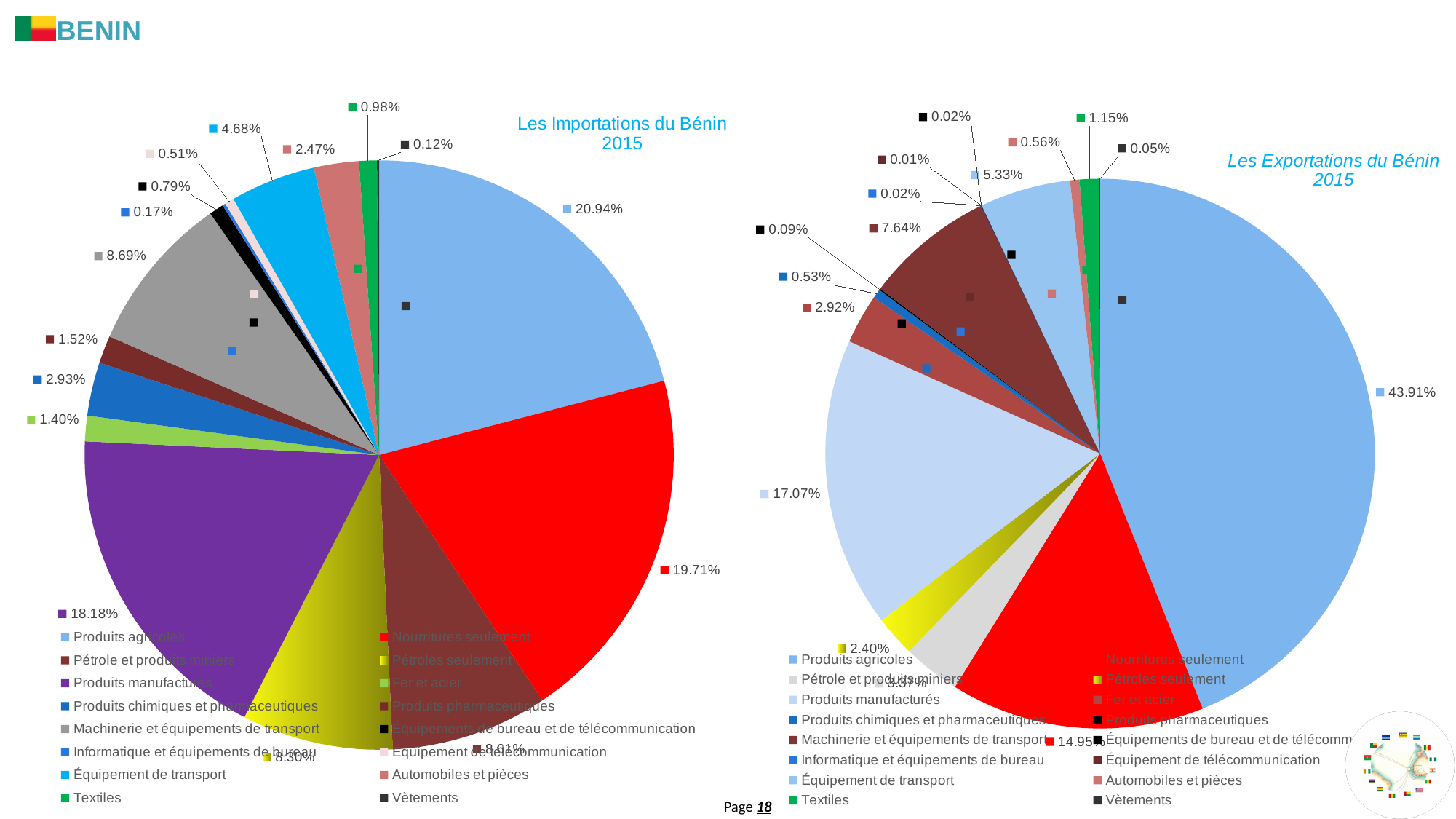
In 'Les Importations du Bénin 2015', which category has the largest slice? Produits agricoles In 'Les Importations du Bénin 2015', what is the share for Produits agricoles? 20.94% In 'Les Exportations du Bénin 2015', which is larger: Produits manufacturés or Nourritures seulement? Produits manufacturés In 'Les Importations du Bénin 2015', what is the share for Équipement de transport? 4.68% How many categories does the legend of 'Les Exportations du Bénin 2015' list? 16 In 'Les Importations du Bénin 2015', what is the difference between Produits agricoles and Nourritures seulement? 1.23% In 'Les Exportations du Bénin 2015', what is the share for Produits agricoles? 43.91% In 'Les Importations du Bénin 2015', what is the share for Produits manufacturés? 18.18% In 'Les Exportations du Bénin 2015', what is the share for Nourritures seulement? 14.95% What kind of chart is 'Les Importations du Bénin 2015'? pie chart In 'Les Exportations du Bénin 2015', which category has the largest slice? Produits agricoles In 'Les Importations du Bénin 2015', which is larger: Machinerie et équipements de transport or Équipement de transport? Machinerie et équipements de transport